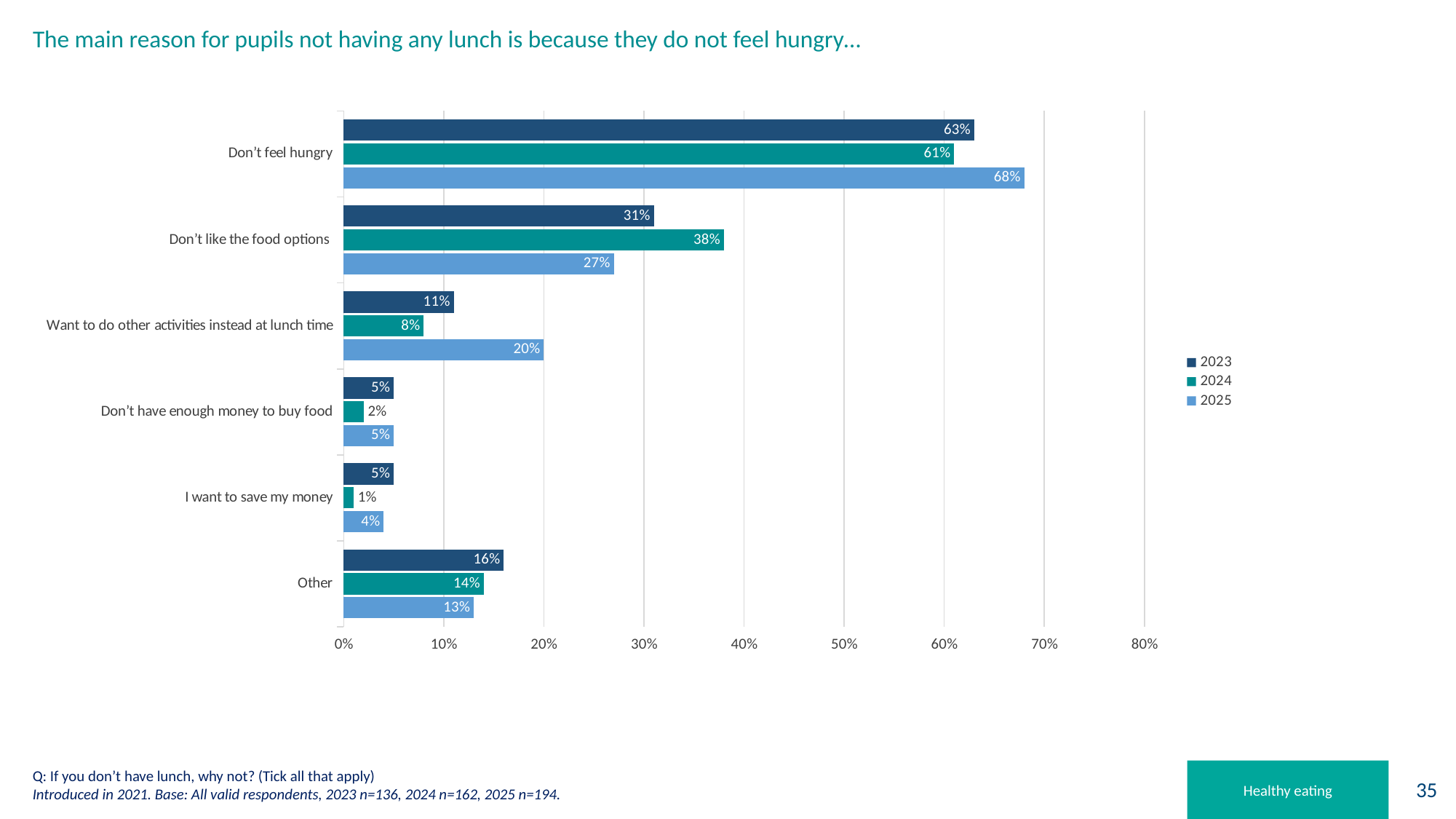
What type of chart is shown on the slide? Bar chart Which reason has the highest value in 2025? Don't feel hungry Which reason has the lowest value in 2024? I want to save my money How many series does the legend list? 3 What is the difference between the 2023 and 2024 values for 'Other'? 2 percentage points What is the 2024 value for 'Don't like the food options'? 38% How many reason categories are shown on the chart? 6 What percentage of pupils in 2025 said they don't feel hungry? 68% Which is larger for 'Don't like the food options': the 2023 value or the 2025 value? 2023 Which years are listed in the chart legend? 2023, 2024, 2025 What is the 2023 value for 'Want to do other activities instead at lunch time'? 11% What is the difference between the 2025 and 2024 values for 'Don't feel hungry'? 7 percentage points